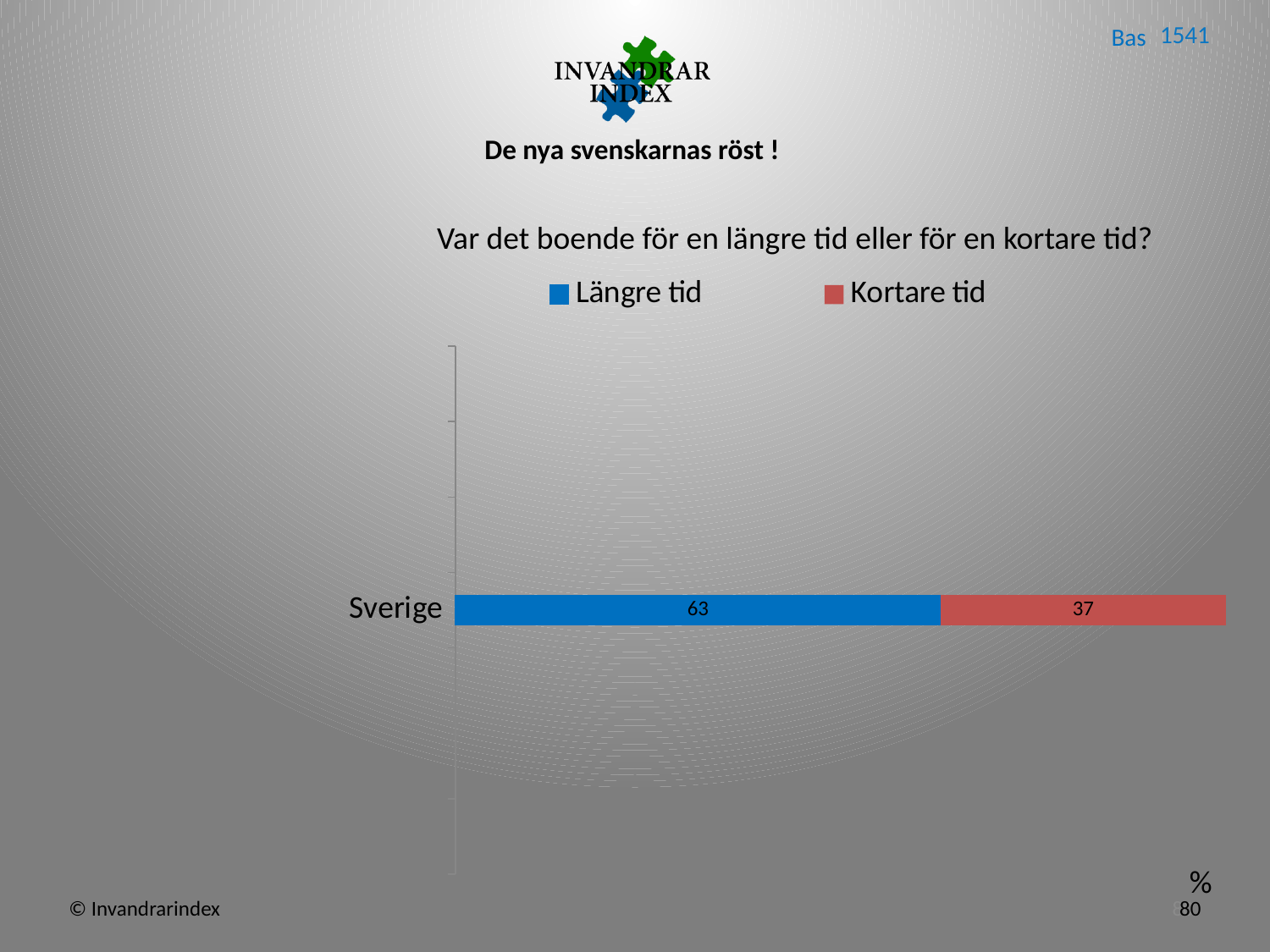
What is the value for Kortare tid for Sverige? 37 What is the title of the chart? Var det boende för en längre tid eller för en kortare tid? Which series has the larger value for Sverige, Längre tid or Kortare tid? Längre tid What kind of chart is shown on the slide? Stacked bar chart What is the total of the stacked bar for Sverige? 100 Which category is shown on the chart? Sverige What is the difference between the Längre tid and Kortare tid values for Sverige? 26 Which colour represents Kortare tid in the chart? Red How many series does the legend list? 2 What is the value for Längre tid for Sverige? 63 How many categories are shown on the chart? 1